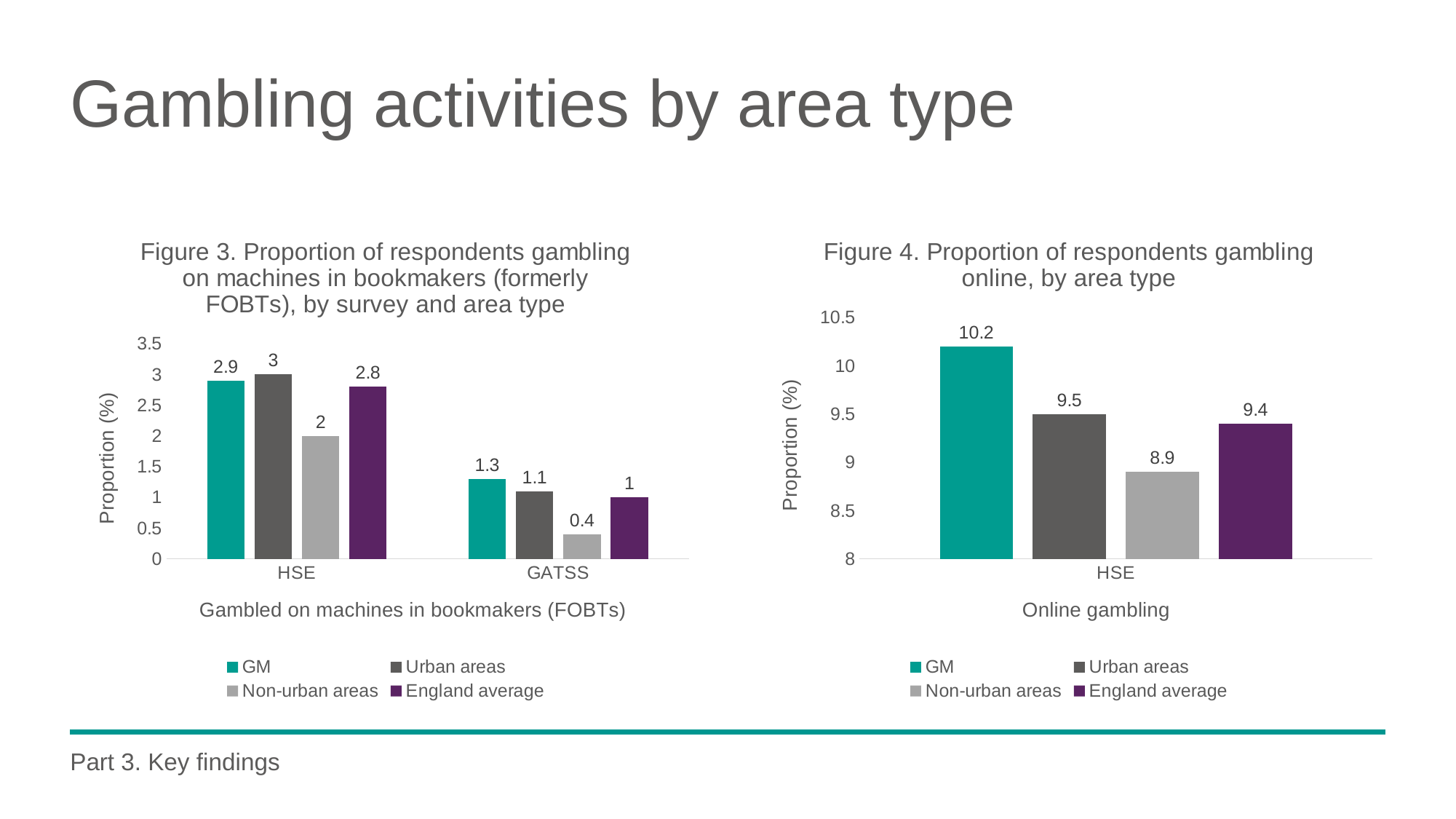
What kind of chart is Figure 4? Bar chart In Figure 4, which area type has the lowest proportion of respondents gambling online? Non-urban areas What is the y-axis label of Figure 3? Proportion (%) In Figure 3, what is the value for Urban areas in the HSE survey? 3 In Figure 3, what is the value for Non-urban areas in the GATSS survey? 0.4 In Figure 3, what is the difference between the GM values for HSE and GATSS? 1.6 In Figure 3, which series has the highest value in the GATSS survey? GM In Figure 4, what is the value for GM? 10.2 How many survey categories are shown on the x axis of Figure 3? 2 In Figure 4, what is the difference between the GM value and the England average value? 0.8 In Figure 3, is the HSE value for Non-urban areas larger or smaller than the HSE value for England average? smaller How many series does the legend in Figure 4 list? 4